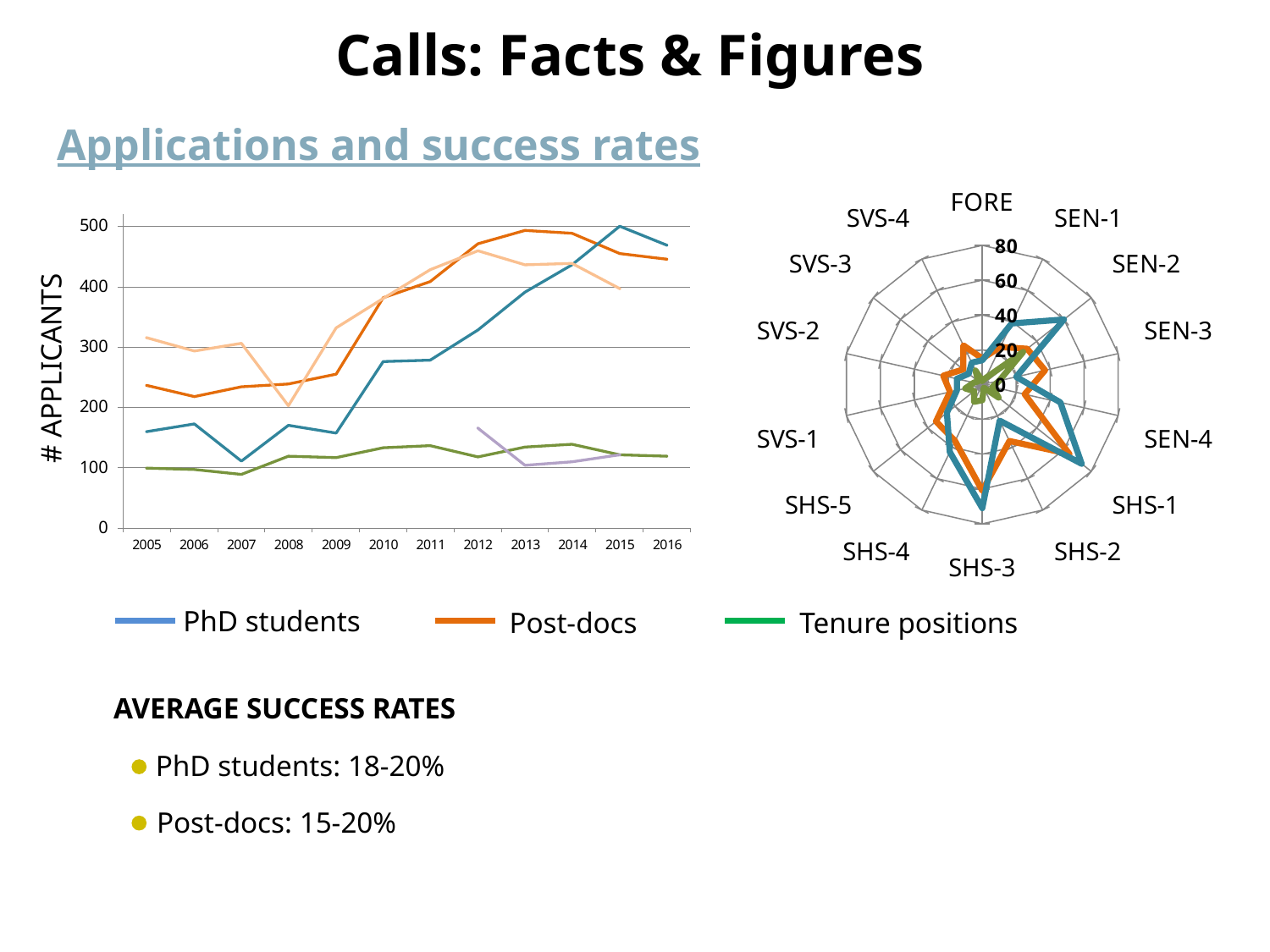
In the line chart on the left, is the value for Tenure positions in 2010 greater or less than 200? less In the line chart on the left, do the values for Post-docs rise or fall from 2009 to 2013? rise In the radar chart on the right, how many categories are shown around the chart? 14 In the line chart on the left, do the values for PhD students rise or fall from 2009 to 2015? rise In the line chart on the left, is the value for PhD students in 2015 greater or less than 400? greater What kind of chart is the chart on the right of the slide? radar chart In the line chart on the left, is the value for Post-docs in 2005 greater or less than 200? greater In the line chart on the left, how many years are shown on the x axis? 12 In the line chart on the left, which is larger in 2015, the value for PhD students or the value for Post-docs? PhD students In the line chart on the left, what is the label of the y axis? # APPLICANTS How many series does the legend below the charts list? 3 What kind of chart is the chart on the left of the slide? line chart